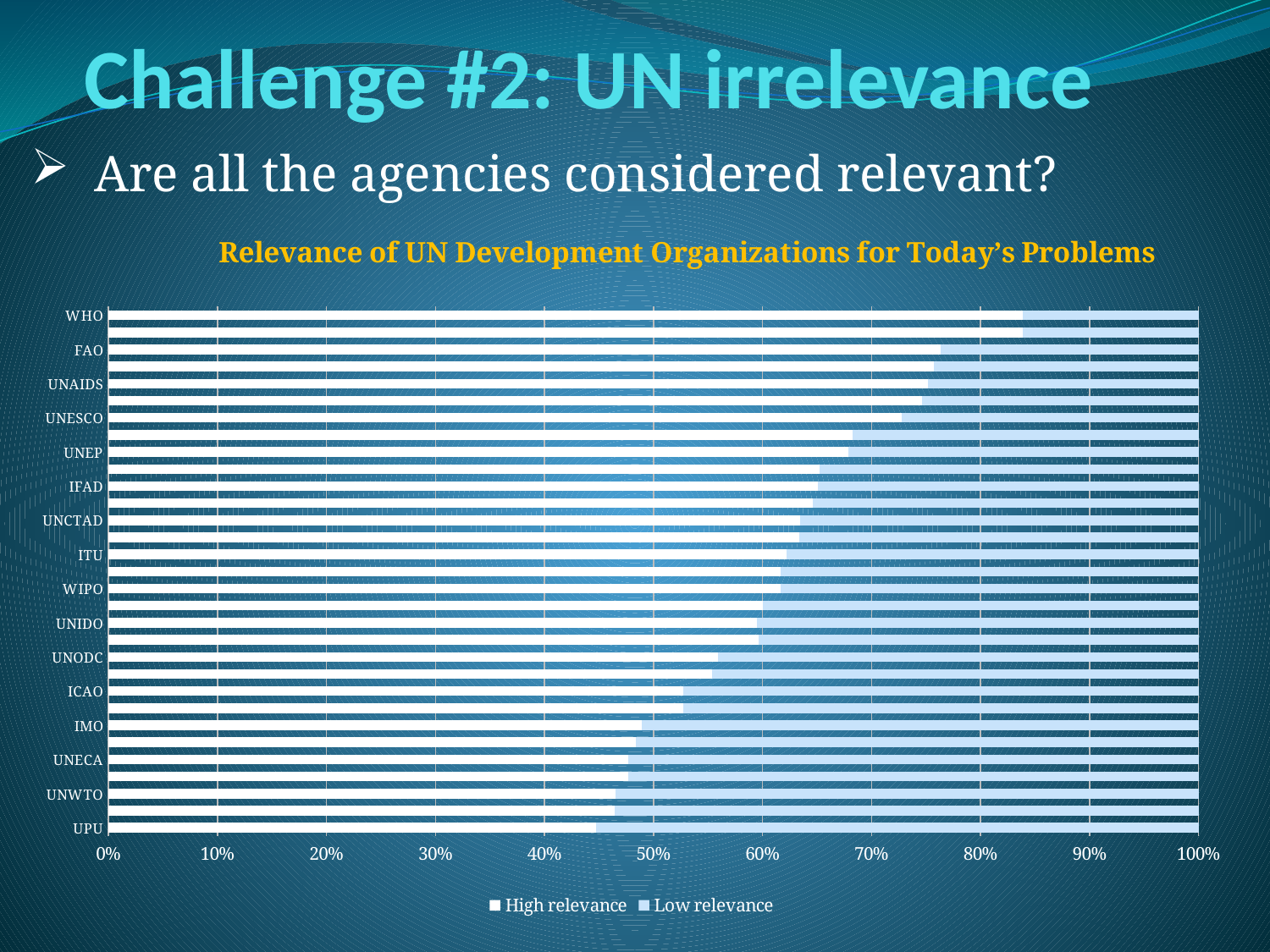
What are the two series named in the legend? High relevance and Low relevance How many series does the legend list? 2 What is the title of the chart? Relevance of UN Development Organizations for Today's Problems Is the High relevance value for UPU greater or less than 50%? less Is the High relevance value for FAO greater or less than 70%? greater Which has a larger High relevance share, FAO or ICAO? FAO Which labelled agency has the highest share of High relevance? WHO Is the High relevance value for UNEP greater or less than 70%? less Going down the chart from WHO to UPU, does the High relevance share rise or fall? fall Which labelled agency has the lowest share of High relevance? UPU What kind of chart is shown on the slide? Stacked bar chart